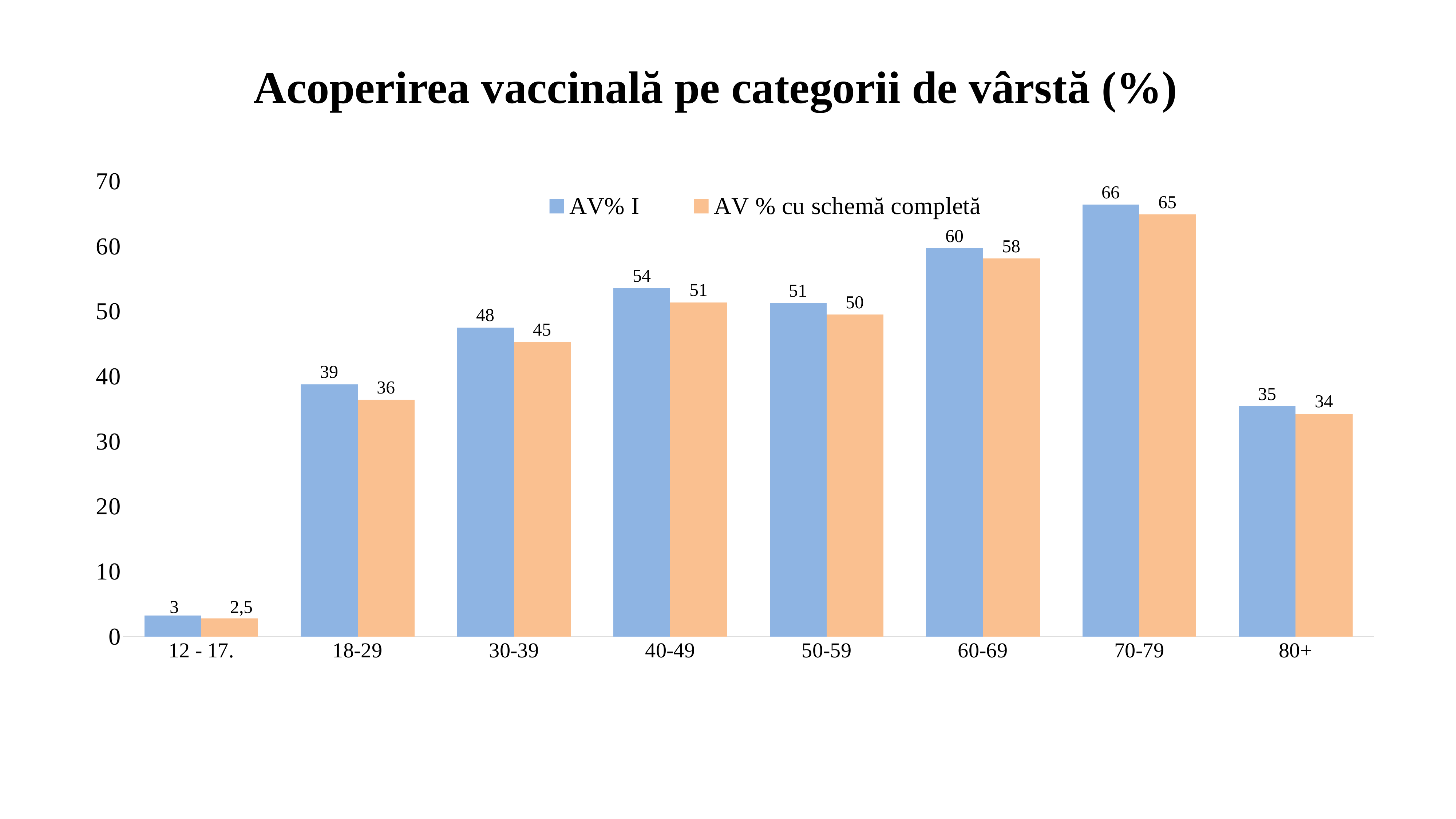
Is the AV % cu schemă completă value for 70-79 greater or less than 60? greater What is the AV% I value for the 40-49 age group? 54 What is the difference between the AV% I and AV % cu schemă completă values for the 30-39 age group? 3 Which age group has the lowest AV % cu schemă completă value? 12 - 17. What is the AV % cu schemă completă value for the 12 - 17. age group? 2,5 What is the title of the chart? Acoperirea vaccinală pe categorii de vârstă (%) How many age groups are shown on the x axis? 8 Which is larger: the AV% I value for 60-69 or the AV% I value for 80+? 60-69 Which age group has the highest AV% I value? 70-79 How many series does the legend list? 2 What kind of chart is shown on the slide? bar chart What is the AV % cu schemă completă value for the 18-29 age group? 36